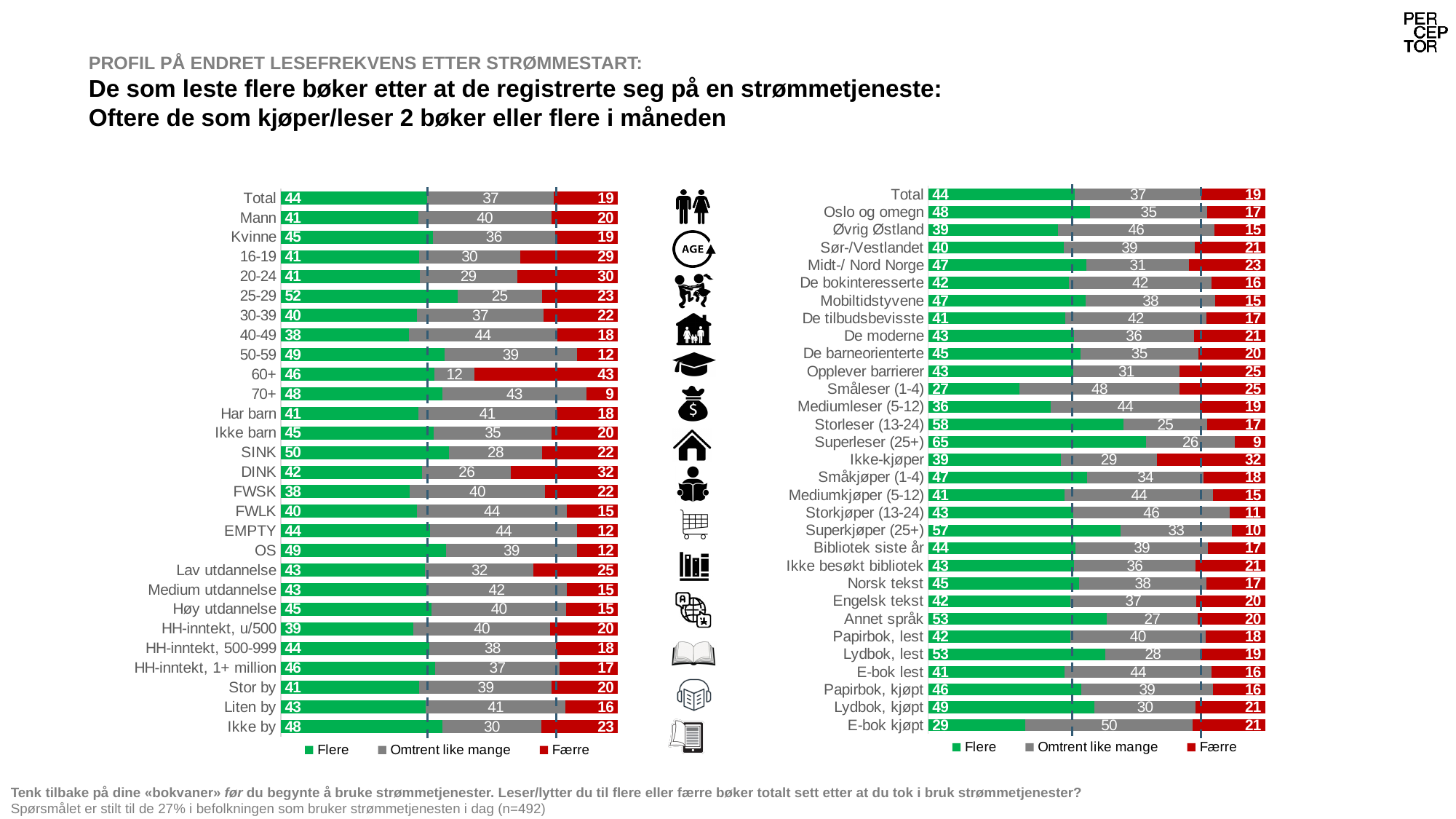
What type of chart is the left chart? Stacked bar chart In the right chart, what is the 'Omtrent like mange' value for E-bok kjøpt? 50 In the left chart, which has the larger 'Færre' value, DINK or SINK? DINK In the left chart, what is the 'Flere' value for 25-29? 52 In the right chart, what is the total of the stacked bar for Ikke-kjøper? 100 How many series does the legend of the right chart list? 3 In the right chart, which category has the lowest 'Flere' value? Småleser (1-4) In the left chart, which category has the lowest 'Færre' value? 70+ In the right chart, which category has the highest 'Flere' value? Superleser (25+) In the left chart, what is the 'Færre' value for 60+? 43 In the right chart, what is the difference between the 'Flere' values for Storleser (13-24) and Mediumleser (5-12)? 22 How many categories are shown in the left chart? 28